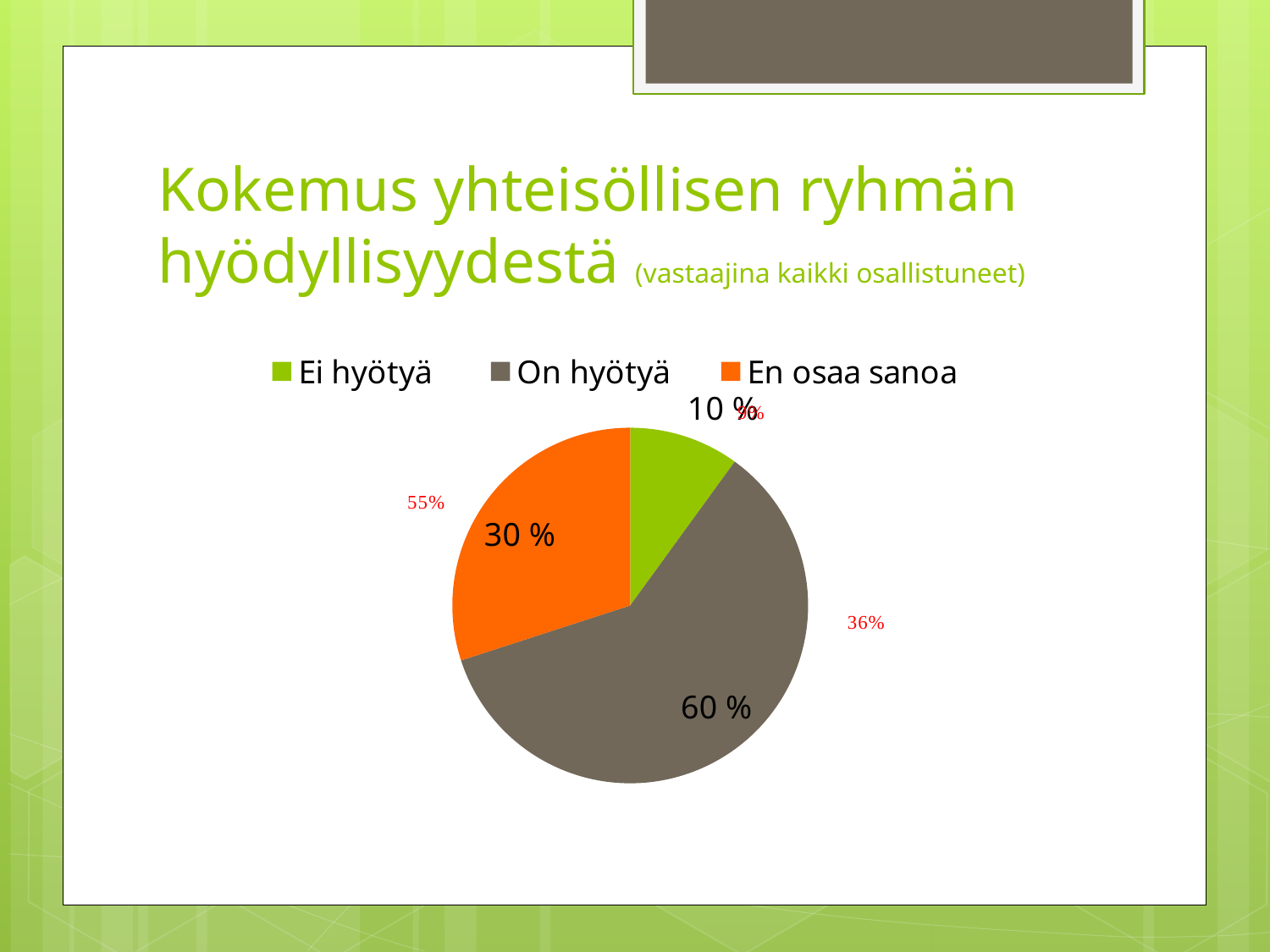
How many slices does the pie chart have? 3 What percentage is shown for the "On hyötyä" slice? 60 % What share of the pie does the "On hyötyä" slice represent? 60 % Which category has the smallest slice of the pie? Ei hyötyä What kind of chart is shown on the slide? pie chart What percentage is shown for the "Ei hyötyä" slice? 10 % What is the difference in percentage points between the "On hyötyä" and "En osaa sanoa" slices? 30 Which category has the largest slice of the pie? On hyötyä How many entries does the legend list? 3 What percentage is shown for the "En osaa sanoa" slice? 30 % What colour is the "En osaa sanoa" slice? orange Which slice is larger, "En osaa sanoa" or "Ei hyötyä"? En osaa sanoa